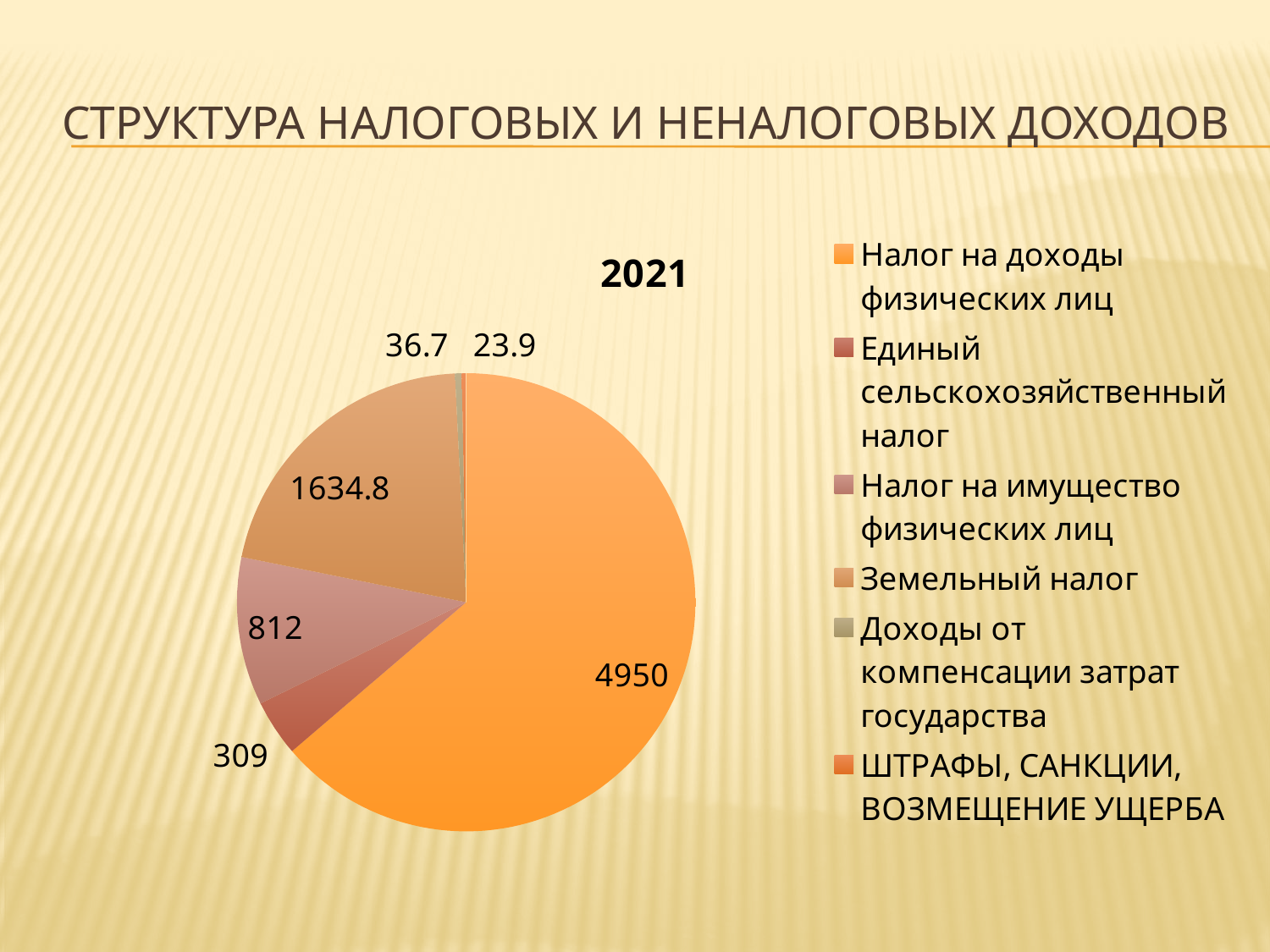
What is the value for Налог на имущество физических лиц in the pie chart? 812 What is the value for Налог на доходы физических лиц in the pie chart? 4950 What is the smallest value labelled on the pie chart? 23.9 How many slices does the pie chart have? 6 What is the difference between the values for Налог на имущество физических лиц and Единый сельскохозяйственный налог? 503 Which category has the largest slice of the pie chart? Налог на доходы физических лиц What is the difference between the values for Налог на доходы физических лиц and Земельный налог? 3315.2 Which is larger: Земельный налог or Налог на имущество физических лиц? Земельный налог What type of chart is shown on the slide? pie chart What year is shown as the title of the pie chart? 2021 What is the value for Земельный налог in the pie chart? 1634.8 What is the value for Единый сельскохозяйственный налог in the pie chart? 309